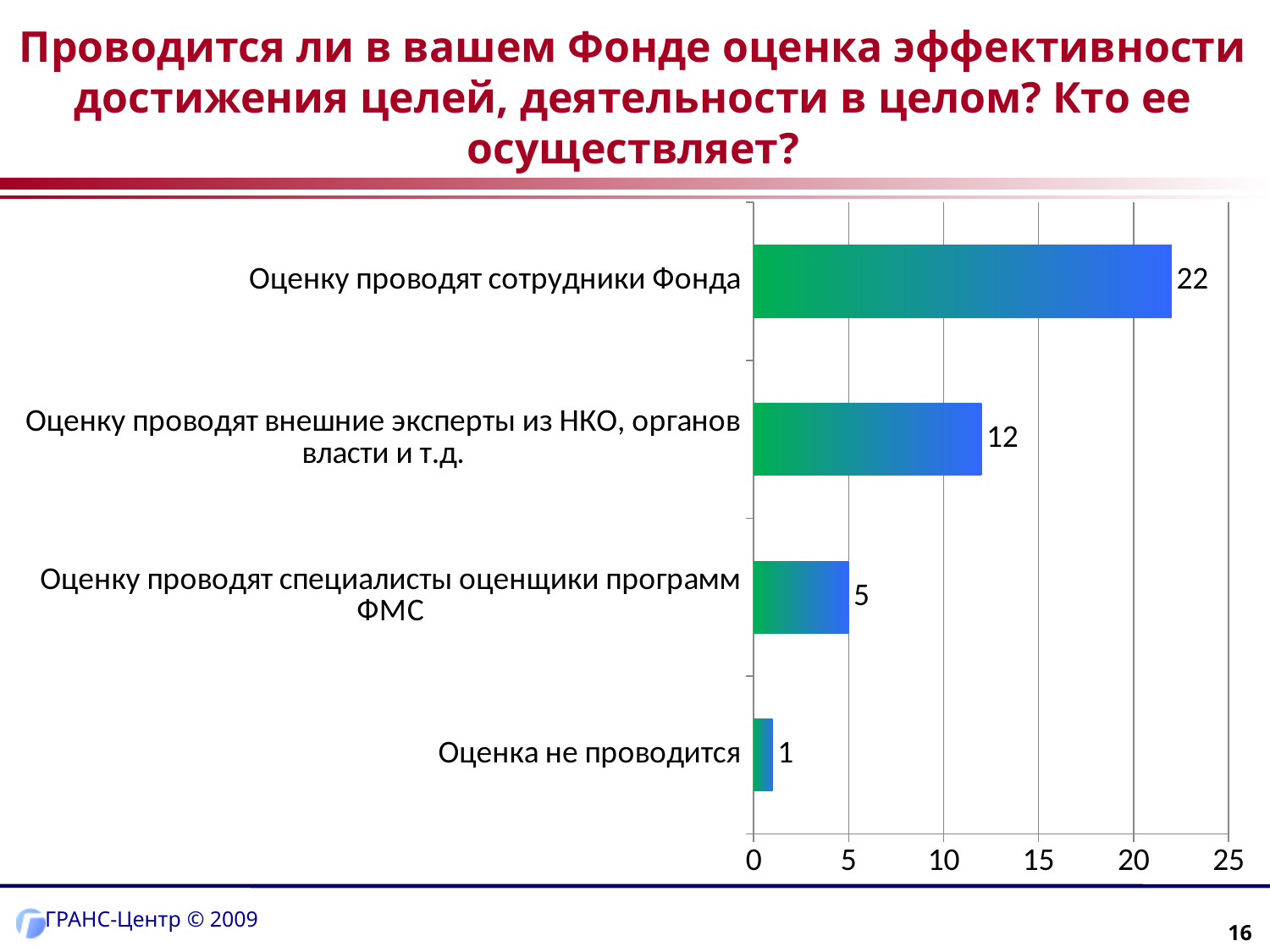
Which category has the lowest value? Оценка не проводится What is the value for "Оценку проводят специалисты оценщики программ ФМС"? 5 What is the value for "Оценка не проводится"? 1 What is the maximum value shown on the horizontal axis? 25 What kind of chart is shown on the slide? bar chart What is the value for "Оценку проводят внешние эксперты из НКО, органов власти и т.д."? 12 Which category has the highest value? Оценку проводят сотрудники Фонда What is the value for "Оценку проводят сотрудники Фонда"? 22 Is the value for "Оценку проводят сотрудники Фонда" greater or less than 20? greater How many categories are shown in the chart? 4 What is the difference between the values for "Оценку проводят сотрудники Фонда" and "Оценку проводят внешние эксперты из НКО, органов власти и т.д."? 10 Which is larger: the value for "Оценку проводят специалисты оценщики программ ФМС" or the value for "Оценка не проводится"? Оценку проводят специалисты оценщики программ ФМС